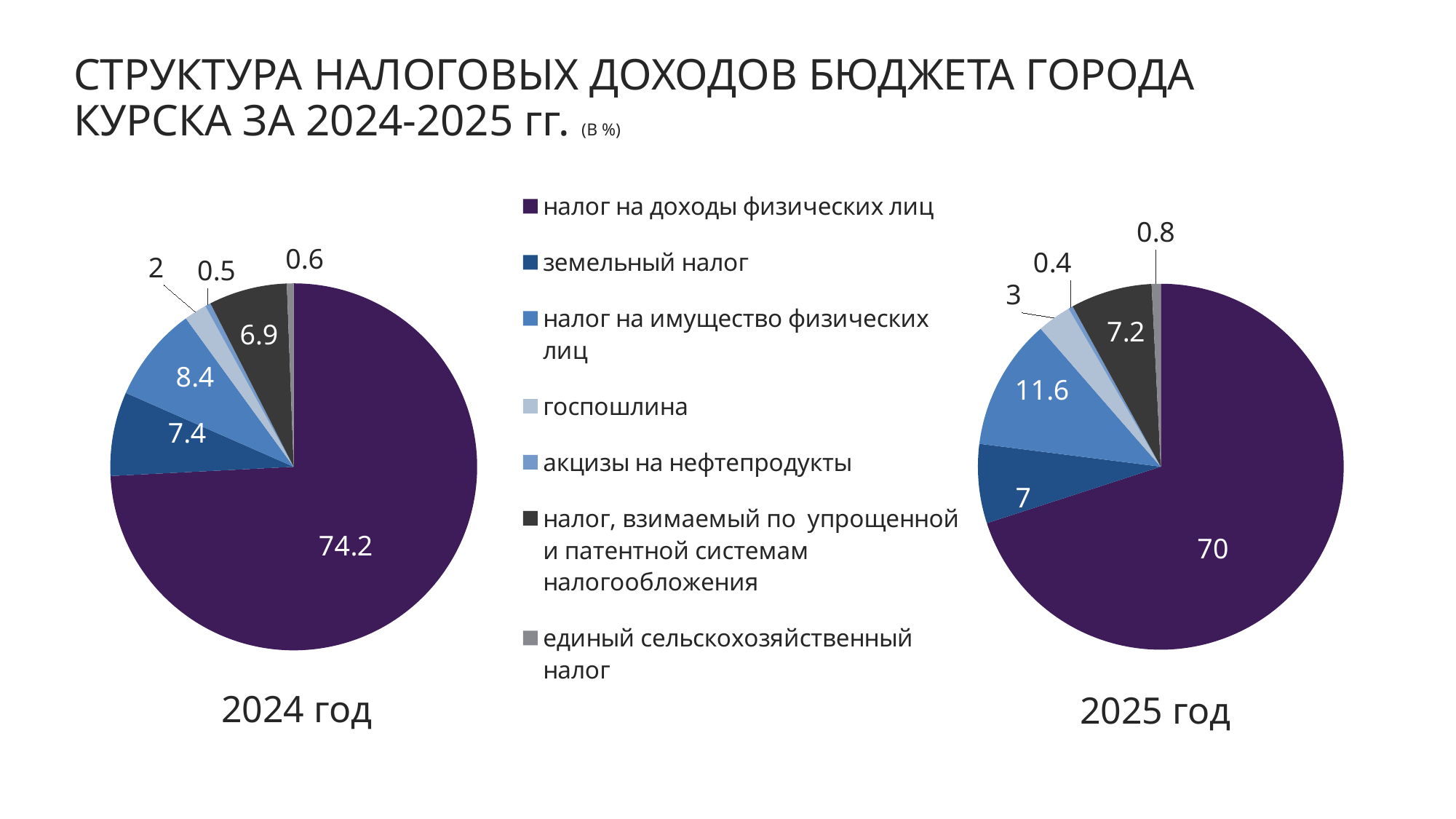
In the 2024 год pie chart, which category has the smallest slice? акцизы на нефтепродукты In the 2024 год pie chart, what is the value for налог на доходы физических лиц? 74.2 What type of chart is used for 2024 год? pie chart In the 2024 год pie chart, which is larger: налог на имущество физических лиц or земельный налог? налог на имущество физических лиц In the 2025 год pie chart, what is the value for налог на имущество физических лиц? 11.6 In the 2025 год pie chart, what is the value for земельный налог? 7 In the 2025 год pie chart, what is the value for госпошлина? 3 In the 2024 год pie chart, what is the value for налог, взимаемый по упрощенной и патентной системам налогообложения? 6.9 How many entries does the legend list? 7 What is the difference between the value for налог на доходы физических лиц in the 2024 год chart and in the 2025 год chart? 4.2 How many slices does the 2025 год pie chart have? 7 In the 2025 год pie chart, which category has the largest slice? налог на доходы физических лиц